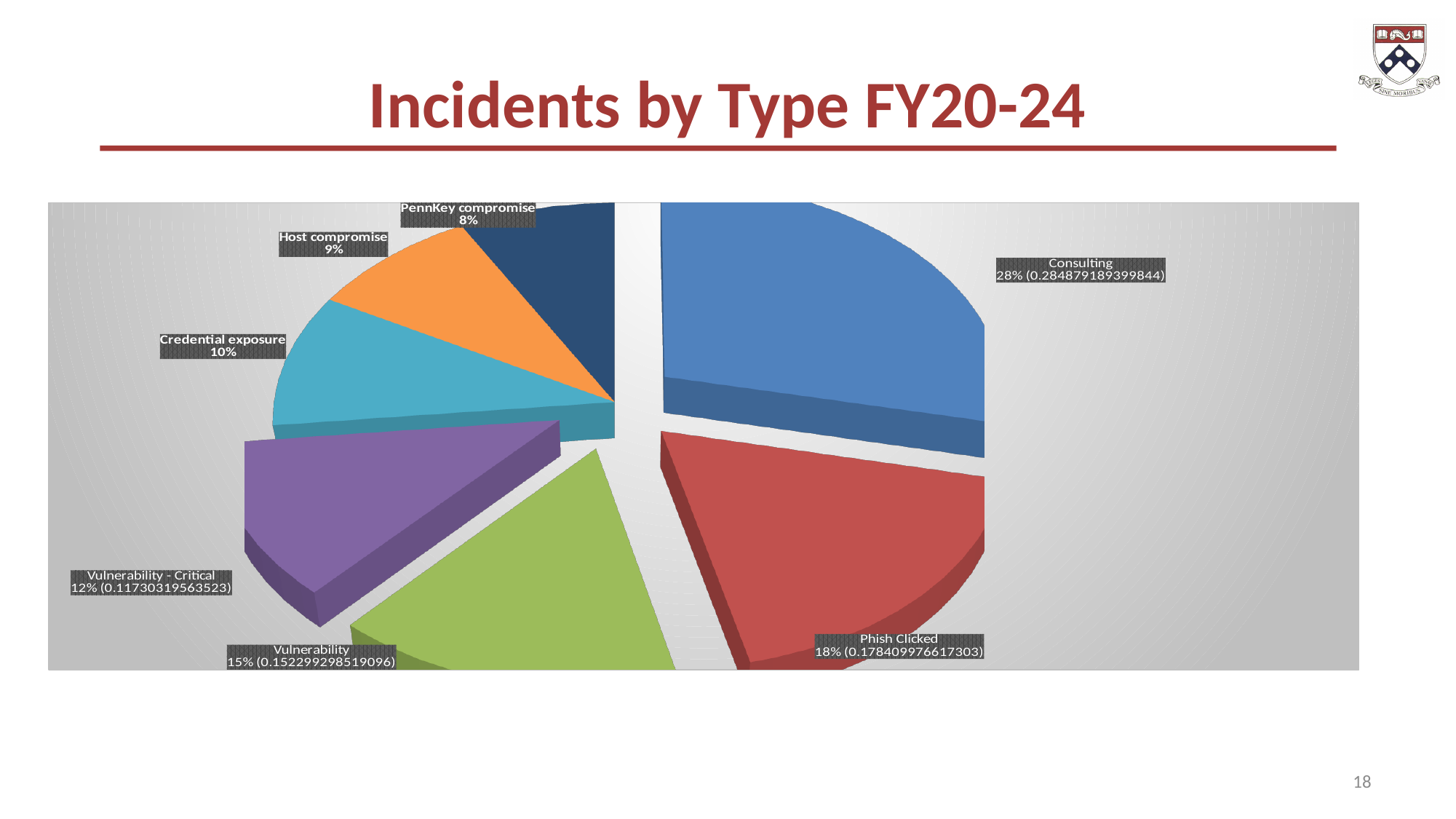
What is the difference in percentage points between Consulting and Phish Clicked? 10 What kind of chart is shown on the slide? Pie chart Which incident type has the smallest share of the pie? PennKey compromise Which has a larger share, Vulnerability or Vulnerability - Critical? Vulnerability Which incident type has the largest share of the pie? Consulting What share of incidents is Consulting? 28% What is the title of the chart? Incidents by Type FY20-24 What percentage is shown for Credential exposure? 10% What percentage is shown for Host compromise? 9% How many incident types (slices) are shown in the pie chart? 7 What percentage is shown for Vulnerability - Critical? 12% What share of incidents is Phish Clicked? 18%